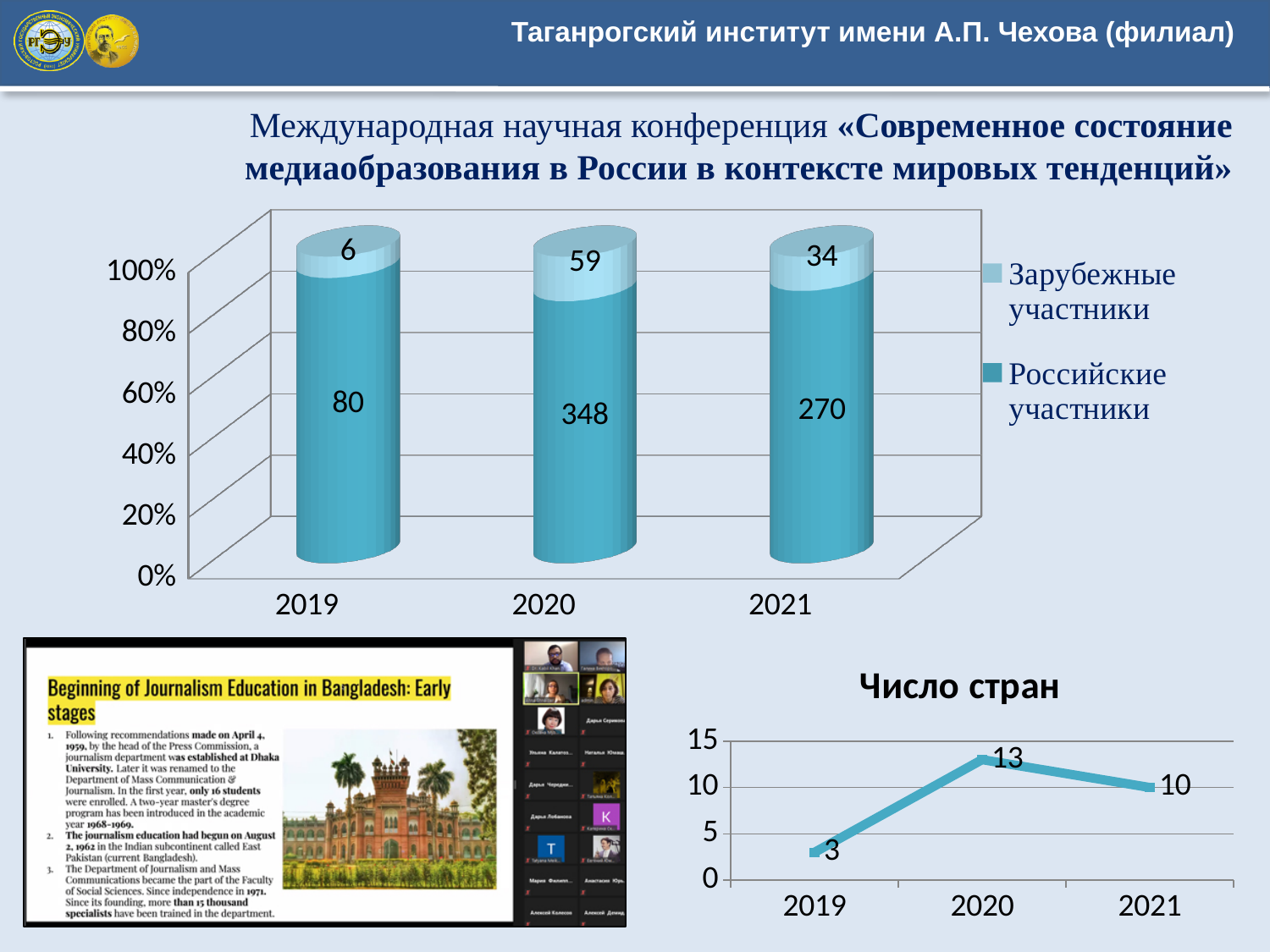
In the top stacked bar chart, what is the value for Российские участники in 2020? 348 In the top stacked bar chart, what is the value for Зарубежные участники in 2019? 6 What kind of chart is the one titled Число стран? Line chart How many series does the legend of the top stacked bar chart list? 2 In the top stacked bar chart, what is the total number of participants (both series) in 2021? 304 In the chart titled Число стран, what is the difference between the values for 2020 and 2019? 10 In the top stacked bar chart, what is the difference between Российские участники in 2020 and in 2021? 78 In the chart titled Число стран, what is the value for 2020? 13 In the chart titled Число стран, which year has the lowest value? 2019 In the top stacked bar chart, what is the value for Зарубежные участники in 2021? 34 In the top stacked bar chart, which year has the lowest value for Зарубежные участники? 2019 In the top stacked bar chart, which year has the highest value for Российские участники? 2020